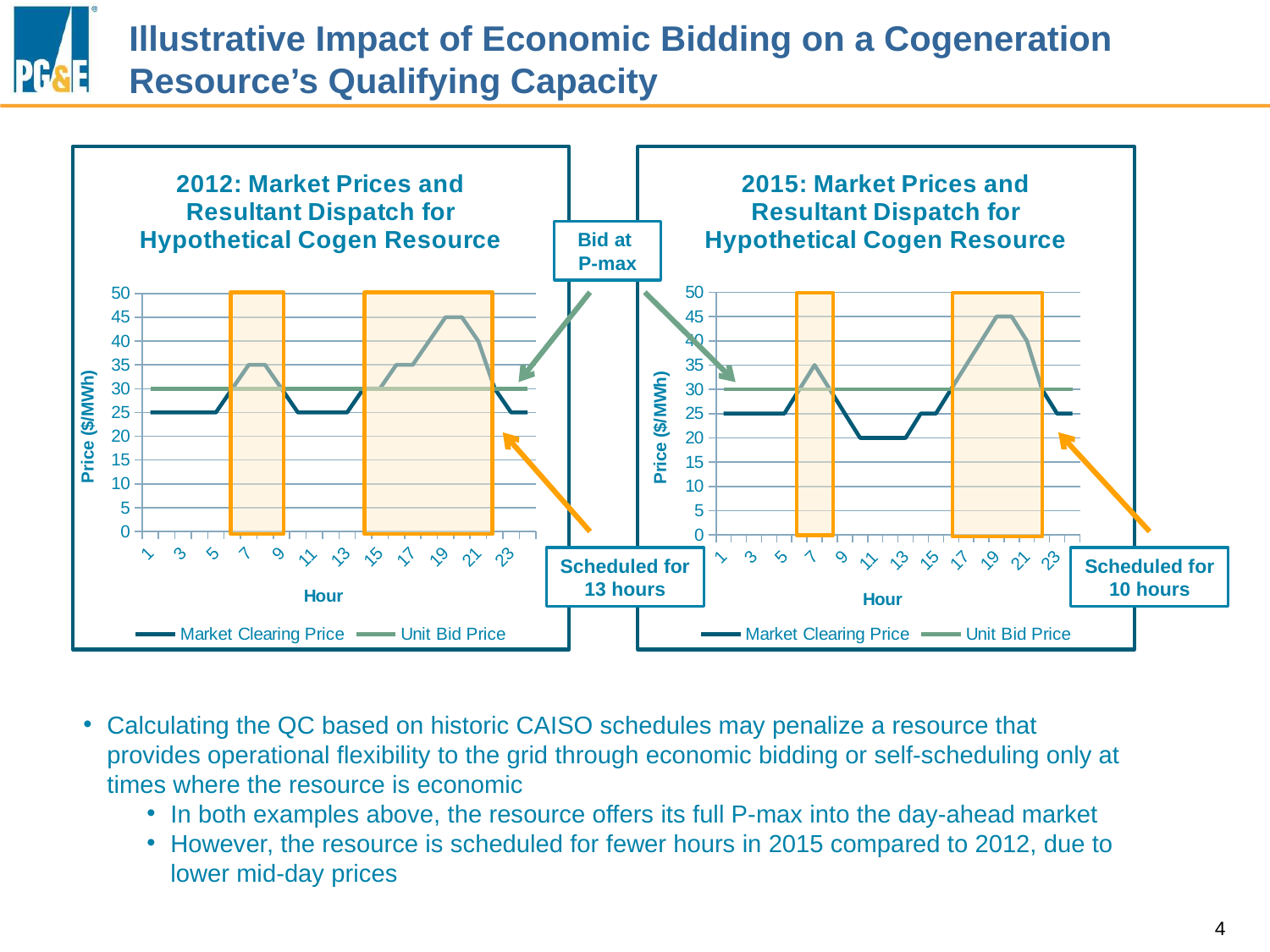
In the 2015 chart, is the Market Clearing Price at hour 19 greater or less than 40? greater In the 2015 chart, at hour 11, which is higher: the Market Clearing Price or the Unit Bid Price? Unit Bid Price According to the annotations, for how many hours is the resource scheduled in the 2015 chart? 10 hours In the 2015 chart, does the Market Clearing Price rise or fall between hour 9 and hour 11? Fall In the 2012 chart, is the Market Clearing Price at hour 1 greater or less than 30? less What kind of chart is the 2012 chart on the left? Line chart How many series does the legend of the 2015 chart list? 2 In the 2015 chart, what is the lowest value the Market Clearing Price reaches? 20 In the 2012 chart, what is the difference between the peak Market Clearing Price and the Unit Bid Price? 15 In the 2012 chart, what is the highest value the Market Clearing Price reaches? 45 What are the two series named in the legend of the 2012 chart? Market Clearing Price and Unit Bid Price In the 2012 chart, what is the constant value of the Unit Bid Price line in $/MWh? 30